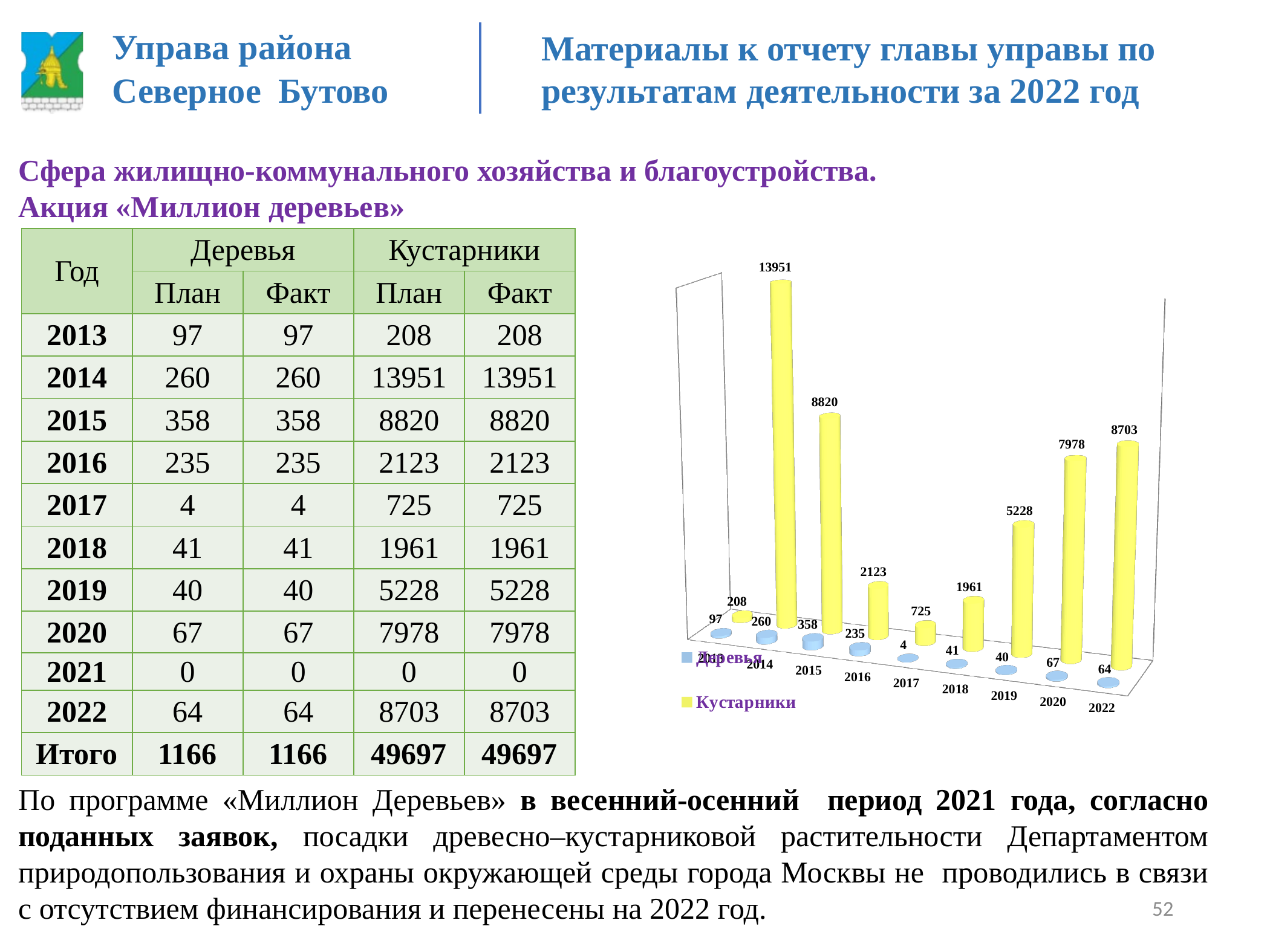
What is the value for Кустарники in 2022 on the chart? 8703 How many series does the chart legend list? 2 What colour are the Кустарники bars on the chart? yellow Which is larger on the chart: Кустарники in 2015 or Кустарники in 2019? 2015 How many years are shown on the x axis of the chart? 9 What is the value for Кустарники in 2014 on the chart? 13951 What is the value for Деревья in 2015 on the chart? 358 Which year has the lowest value for Деревья on the chart? 2017 What kind of chart is shown on the slide? bar chart Which year has the highest value for Кустарники on the chart? 2014 Do the Кустарники values rise or fall from 2018 to 2022 on the chart? rise What is the difference between the Кустарники values for 2022 and 2020 on the chart? 725